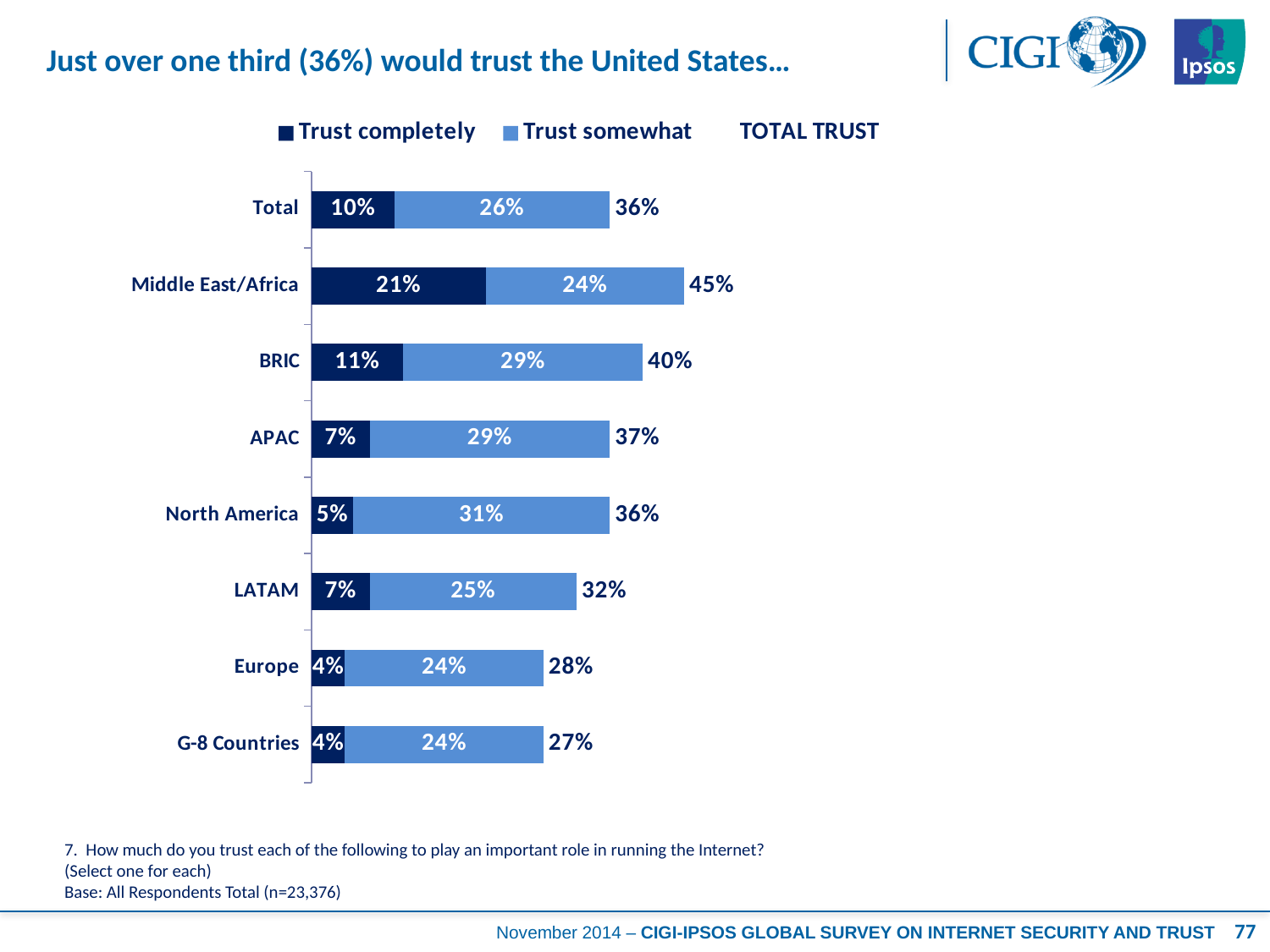
How many categories are shown on the chart? 8 What kind of chart is shown on the slide? Bar chart What is the difference between the TOTAL TRUST values for Middle East/Africa and Europe? 17% Which is larger, the 'Trust somewhat' value for BRIC or for LATAM? BRIC How many series does the legend list? 3 What is the 'Trust completely' value for Middle East/Africa? 21% What is the TOTAL TRUST value for BRIC? 40% Which region has the lowest TOTAL TRUST value? G-8 Countries Which legend entry is shown in dark navy blue? Trust completely What is the total of the stacked bar for APAC? 37% Which region has the highest TOTAL TRUST value? Middle East/Africa What is the 'Trust somewhat' value for North America? 31%